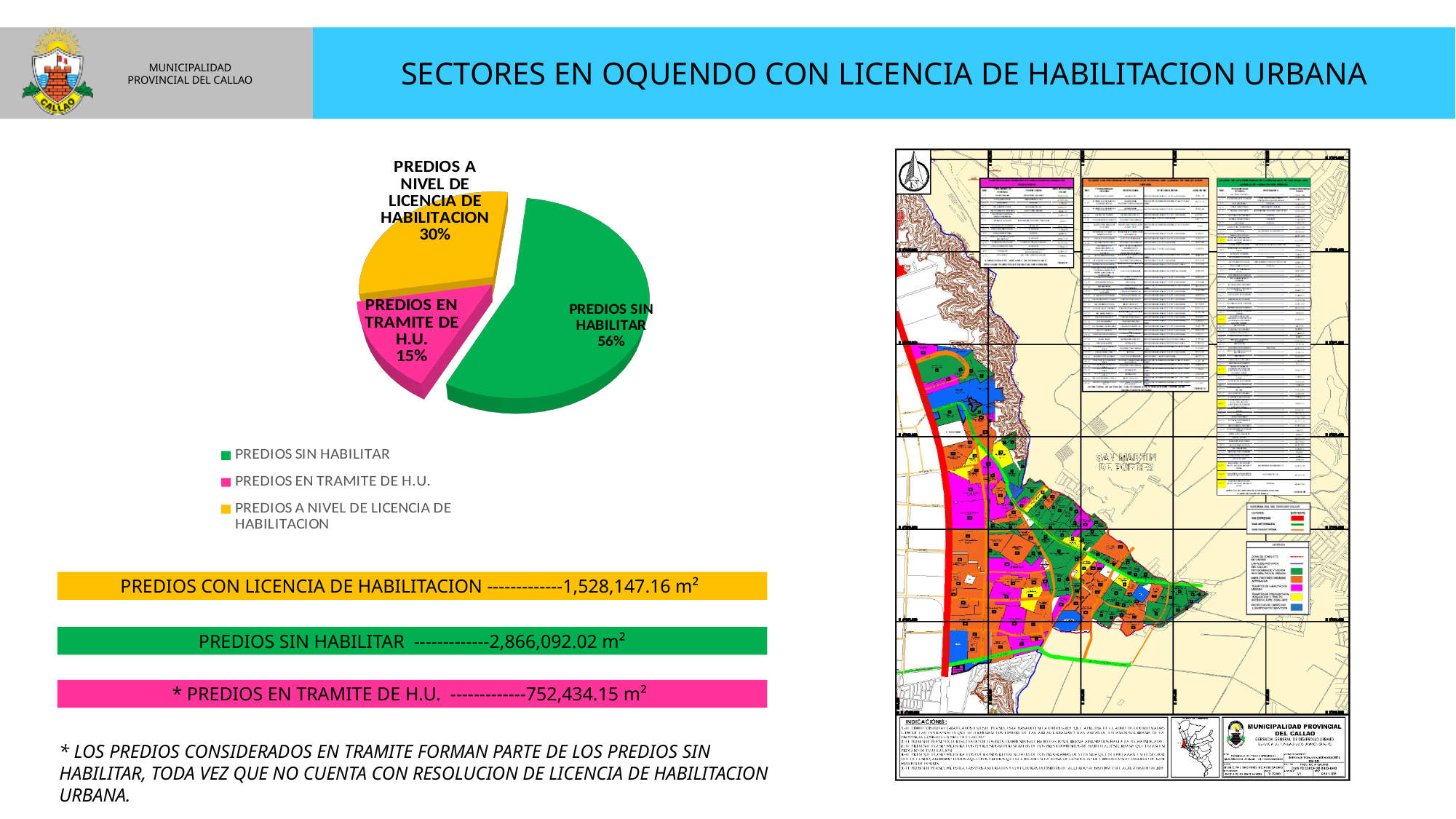
Which is larger, the slice for PREDIOS A NIVEL DE LICENCIA DE HABILITACION or the slice for PREDIOS EN TRAMITE DE H.U.? PREDIOS A NIVEL DE LICENCIA DE HABILITACION What colour is the PREDIOS SIN HABILITAR slice in the pie chart? green What colour is the PREDIOS EN TRAMITE DE H.U. slice in the pie chart? pink What share of the pie does PREDIOS SIN HABILITAR represent? 56% Which category has the smallest slice of the pie? PREDIOS EN TRAMITE DE H.U. What kind of chart is shown on the slide? pie chart How many entries does the legend of the pie chart list? 3 Which category has the largest slice of the pie? PREDIOS SIN HABILITAR What share of the pie does PREDIOS EN TRAMITE DE H.U. represent? 15% What share of the pie does PREDIOS A NIVEL DE LICENCIA DE HABILITACION represent? 30% How many slices does the pie chart have? 3 What is the difference in percentage points between PREDIOS SIN HABILITAR and PREDIOS A NIVEL DE LICENCIA DE HABILITACION? 26